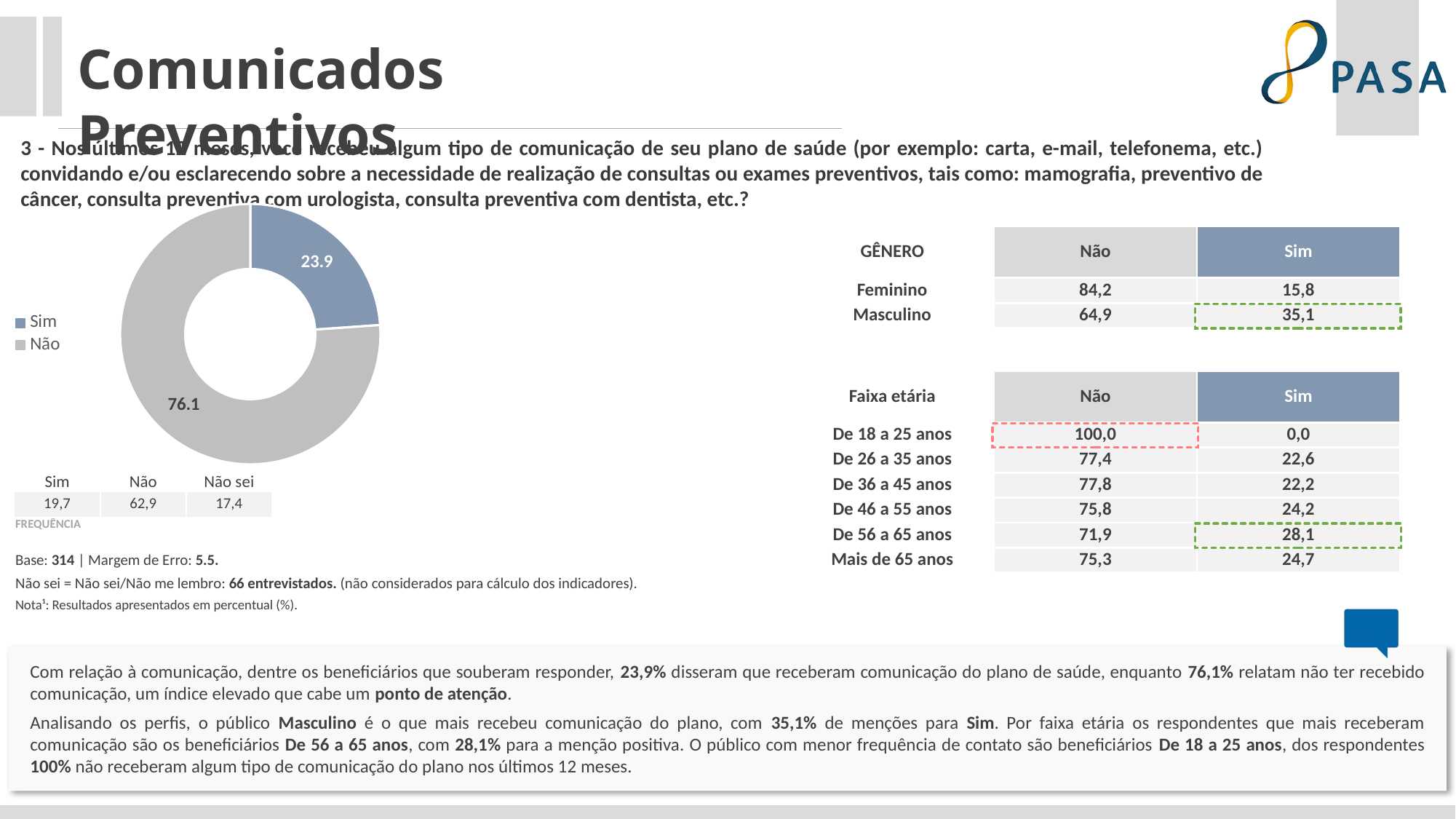
What are the two legend entries of the donut chart? Sim and Não Which slice of the donut chart is the largest? Não Which slice of the donut chart is the smallest? Sim How many slices does the donut chart have? 2 In the donut chart, what is the difference between the Não value and the Sim value? 52.2 How many entries does the legend of the donut chart list? 2 In the donut chart, what value is shown for the Não slice? 76.1 In the donut chart, what value is shown for the Sim slice? 23.9 What share of the donut chart does the Sim slice represent? 23.9 What colour is the Sim slice in the donut chart? Blue In the donut chart, which is larger, Sim or Não? Não What kind of chart is shown on the left of the slide? Doughnut chart